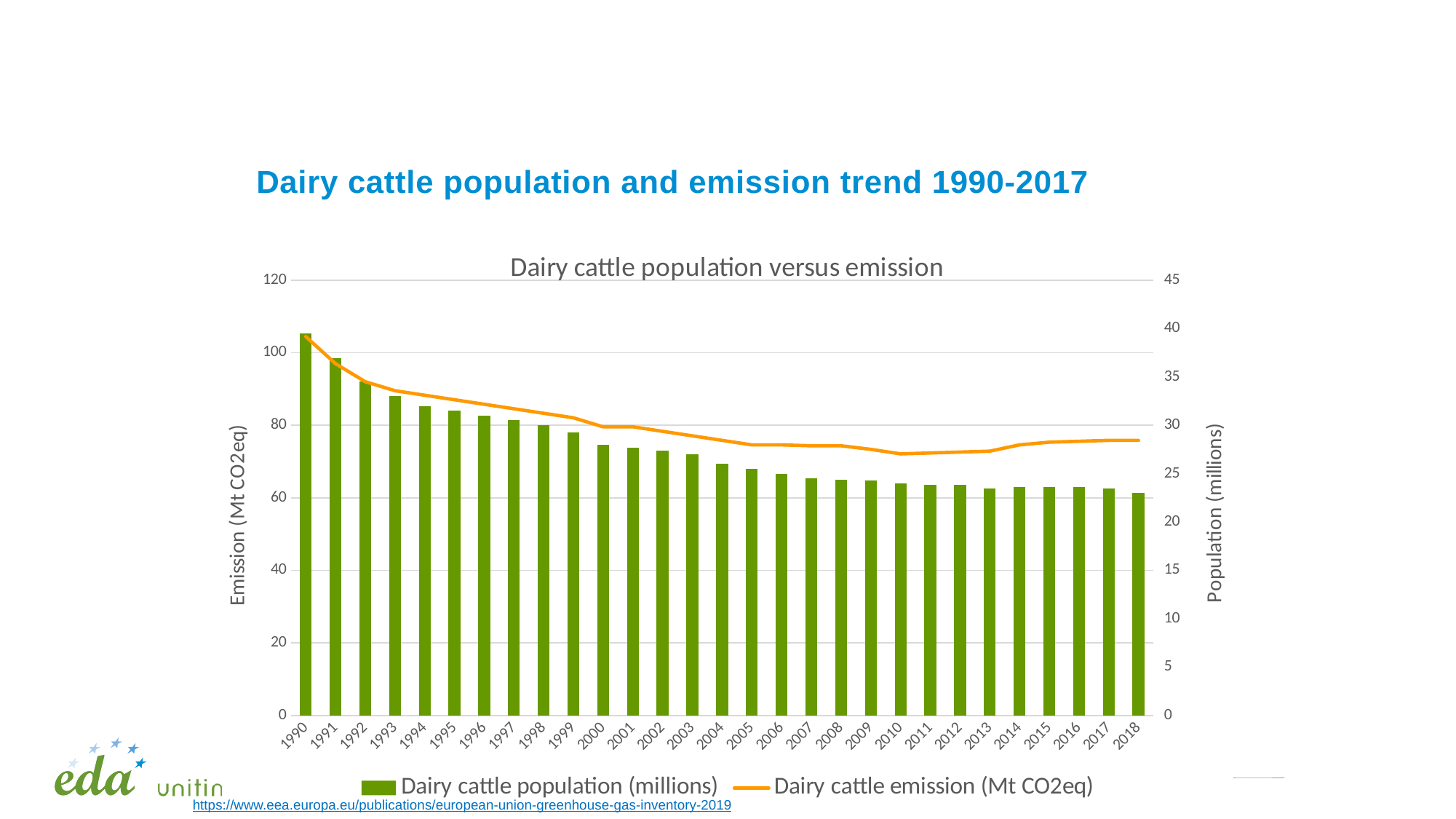
Which year has the shortest bar for dairy cattle population? 2018 Does the dairy cattle emission line generally rise or fall from 1990 to 2010? Fall Is the dairy cattle emission line higher in 1990 or in 2010? 1990 What is the title printed above the chart? Dairy cattle population versus emission How many years are shown along the x axis of the chart? 29 Do the dairy cattle population bars generally rise or fall from 1990 to 2018? Fall How many series does the chart legend list? 2 Which year has the larger dairy cattle population bar, 1990 or 2018? 1990 What colour is the line for dairy cattle emission (Mt CO2eq)? Orange Which year has the tallest bar for dairy cattle population? 1990 Which year has the larger dairy cattle population bar, 1995 or 2005? 1995 What kind of chart is shown on the slide? A bar chart combined with a line chart